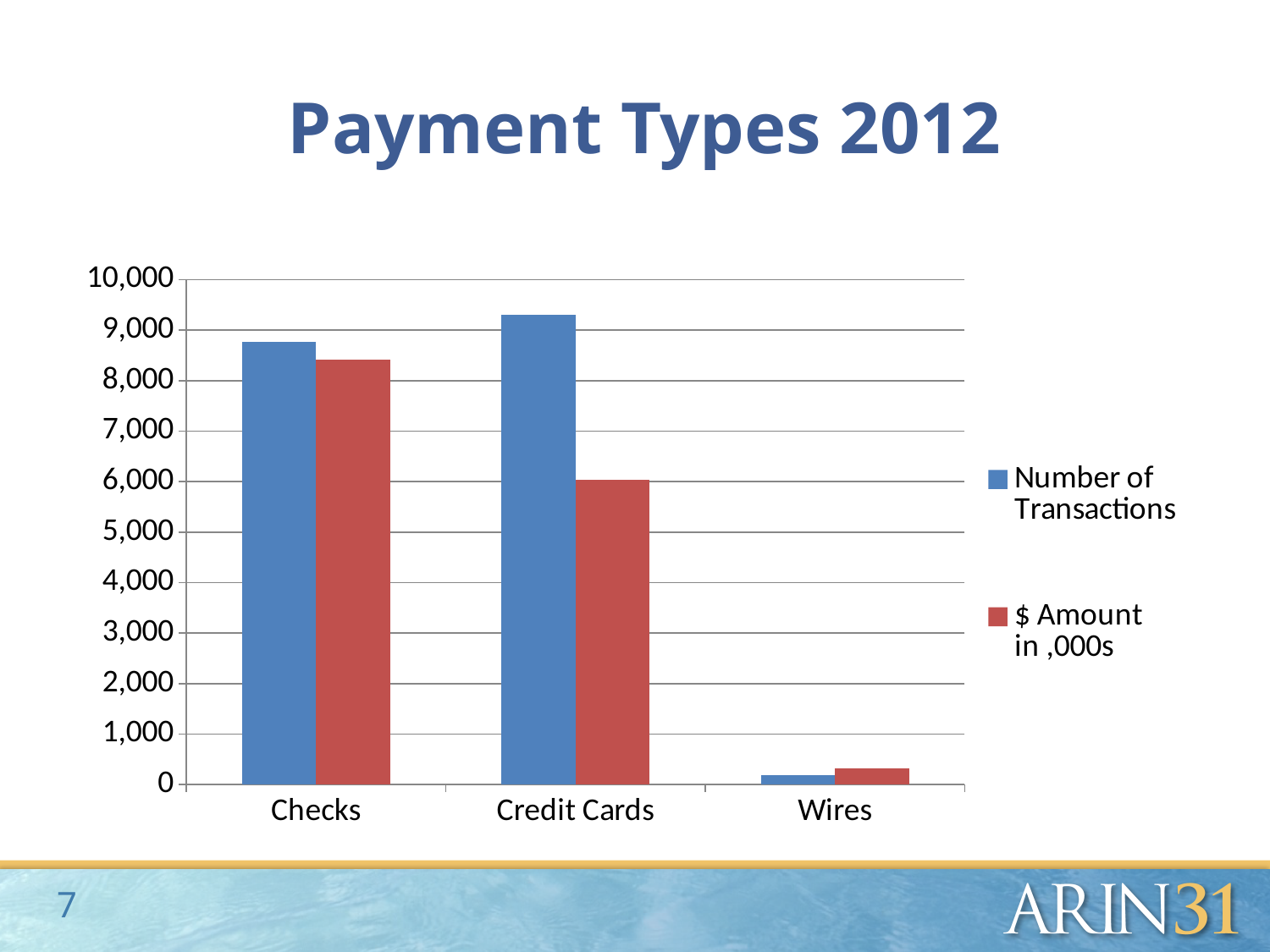
Which series is shown in red in the legend? $ Amount in ,000s Which payment type has the highest $ Amount in ,000s? Checks Is the Number of Transactions for Checks greater or less than 8,000? greater For Credit Cards, which is larger: Number of Transactions or $ Amount in ,000s? Number of Transactions Which payment type has the highest Number of Transactions? Credit Cards How many payment type categories are shown on the x axis? 3 Which has a larger Number of Transactions: Checks or Credit Cards? Credit Cards Which payment type has the lowest Number of Transactions? Wires What is the title of the chart? Payment Types 2012 Is the $ Amount in ,000s for Credit Cards greater or less than 7,000? less What kind of chart is shown on the slide? bar chart How many series does the legend list? 2